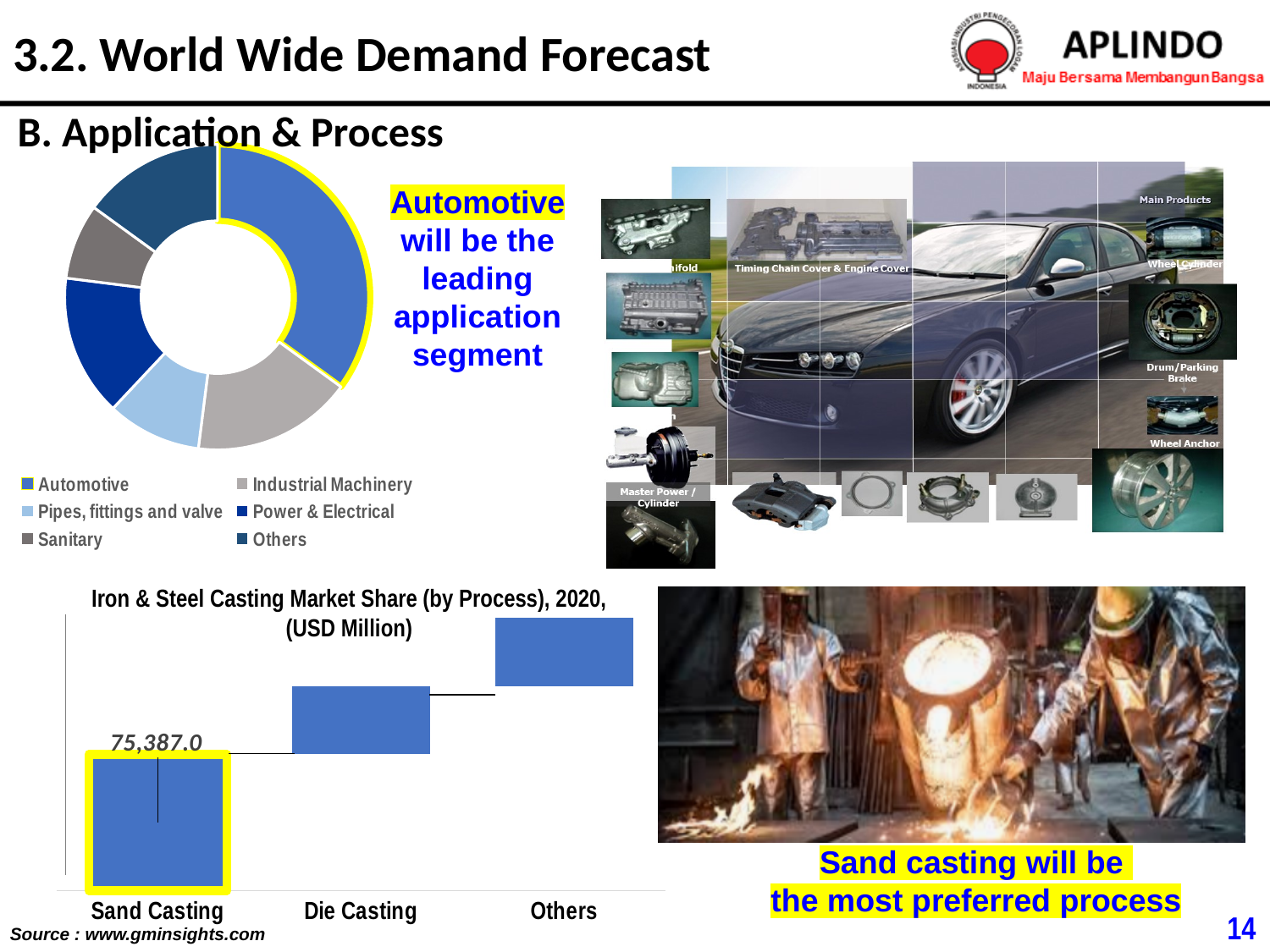
What is the title of the chart at the bottom left of the slide? Iron & Steel Casting Market Share (by Process), 2020, (USD Million) In the bar chart at the bottom left, how many process categories are shown on the x axis? 3 What kind of chart is the 'Iron & Steel Casting Market Share (by Process), 2020' chart? bar chart In the bar chart at the bottom left, which process category has the highest value? Sand Casting How many entries does the legend of the doughnut chart under 'B. Application & Process' list? 6 What kind of chart is shown under 'B. Application & Process' on the left of the slide? doughnut chart In the bar chart at the bottom left, which category's bar is outlined with a yellow highlight? Sand Casting In the bar chart titled 'Iron & Steel Casting Market Share (by Process), 2020, (USD Million)', what is the value for Sand Casting? 75,387.0 In the doughnut chart under 'B. Application & Process', which slice is larger, Industrial Machinery or Pipes, fittings and valve? Industrial Machinery In the doughnut chart under 'B. Application & Process', which application segment has the largest slice? Automotive In the doughnut chart under 'B. Application & Process', which slice is larger, Automotive or Sanitary? Automotive In the bar chart at the bottom left, which is larger, Sand Casting or Die Casting? Sand Casting